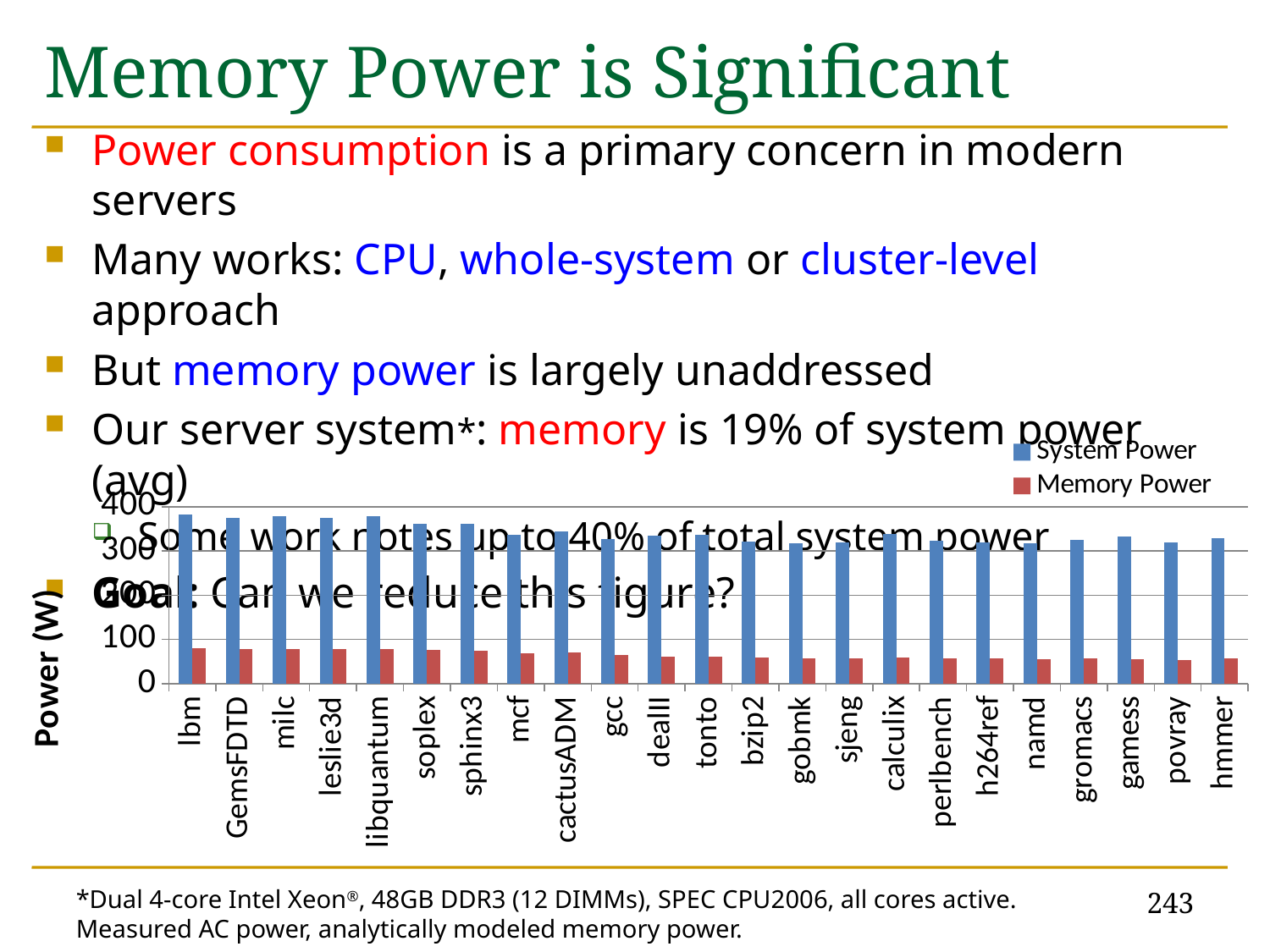
How many series does the chart's legend list? 2 Is the System Power value for hmmer greater or less than 400? less Which series is shown in blue in the chart? System Power What is the label on the chart's vertical axis? Power (W) Is the Memory Power value for lbm greater or less than 100? less Is the Memory Power value for hmmer greater or less than 100? less What kind of chart is shown on the slide? bar chart Which is larger, the System Power for lbm or the System Power for hmmer? lbm How many benchmark categories are plotted along the x axis? 23 Do the Memory Power values generally rise or fall moving from left to right along the x axis? fall Which is larger, the Memory Power for lbm or the Memory Power for povray? lbm